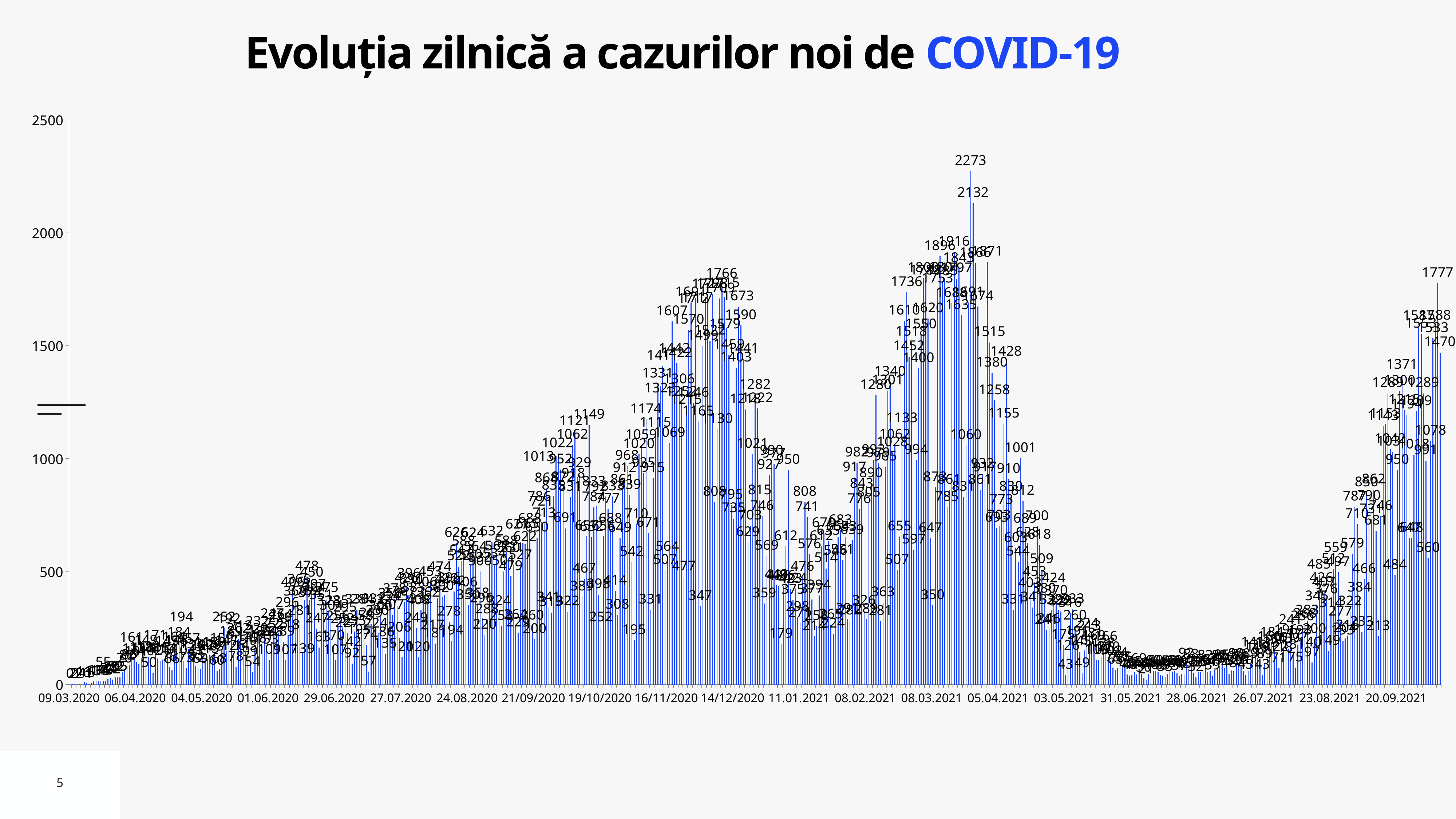
Do the values rise or fall between 05.04.2021 and 31.05.2021? fall Is the highest bar on the chart greater or less than 2000? greater What kind of chart is shown on the slide? bar chart What is the second-highest daily value labeled on the chart? 2132 Which is larger: the peak value of 2273 or the last labeled value of 1777? 2273 What is the title of the chart? Evoluția zilnică a cazurilor noi de COVID-19 Are the values around 31.05.2021 greater or less than 500? less What is the highest daily value labeled on the chart? 2273 What is the difference between the two highest labeled values, 2273 and 2132? 141 Do the values rise or fall between 26.07.2021 and 20.09.2021? rise What is the maximum value shown on the vertical axis? 2500